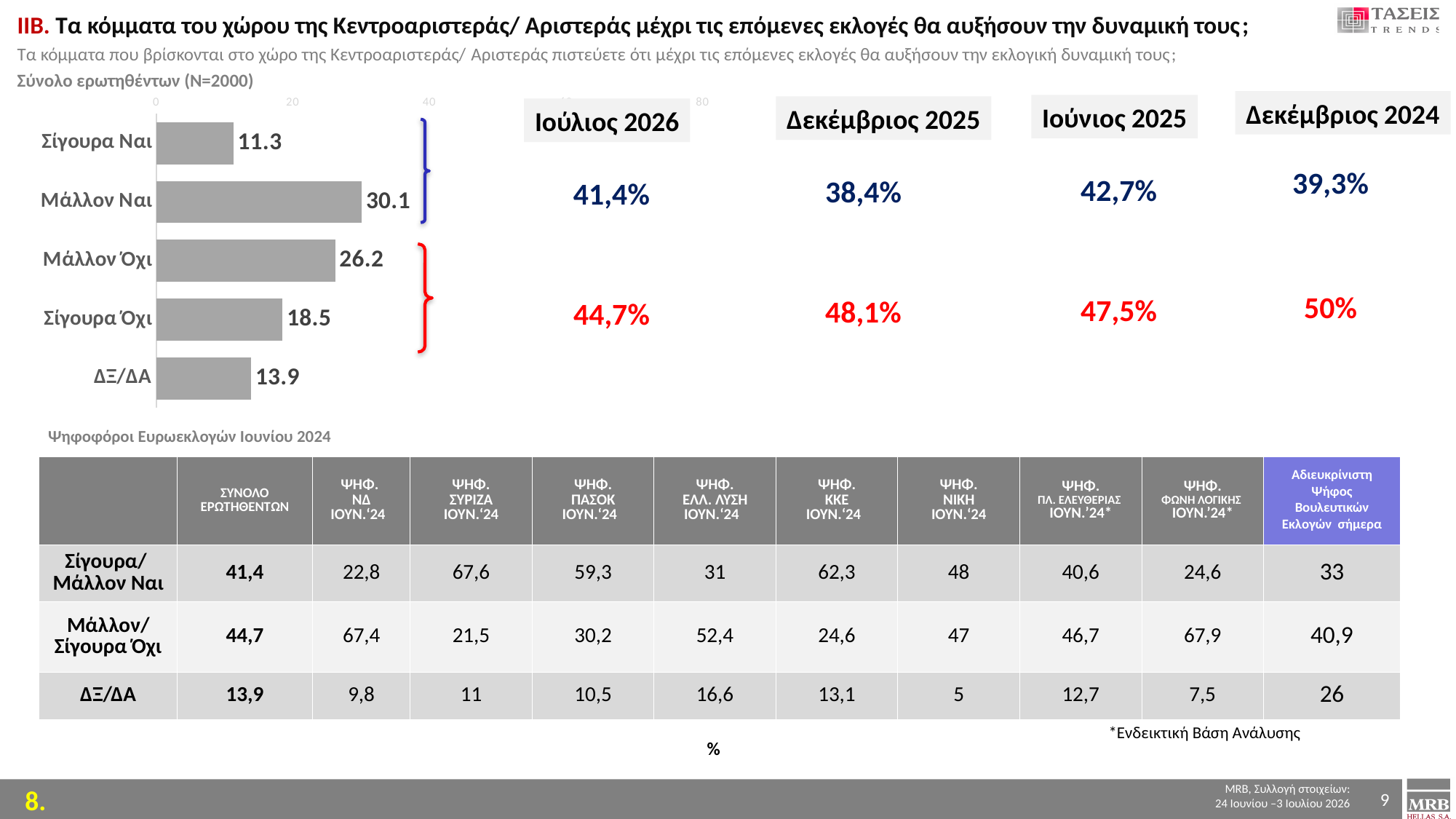
What is the value for ΔΞ/ΔΑ in the bar chart? 13.9 What is the value for Σίγουρα Όχι in the bar chart? 18.5 Is the value for Μάλλον Όχι in the bar chart greater or less than 20? greater What is the value for Μάλλον Ναι in the bar chart? 30.1 What colour are the bars in the bar chart? grey Which category has the lowest value in the bar chart? Σίγουρα Ναι What kind of chart is shown on the slide? bar chart How many categories are shown in the bar chart? 5 Which category has the highest value in the bar chart? Μάλλον Ναι Which is larger in the bar chart, Σίγουρα Όχι or ΔΞ/ΔΑ? Σίγουρα Όχι What is the difference between the values for Μάλλον Ναι and Μάλλον Όχι in the bar chart? 3.9 What is the combined value of Σίγουρα Ναι and Μάλλον Ναι in the bar chart? 41.4